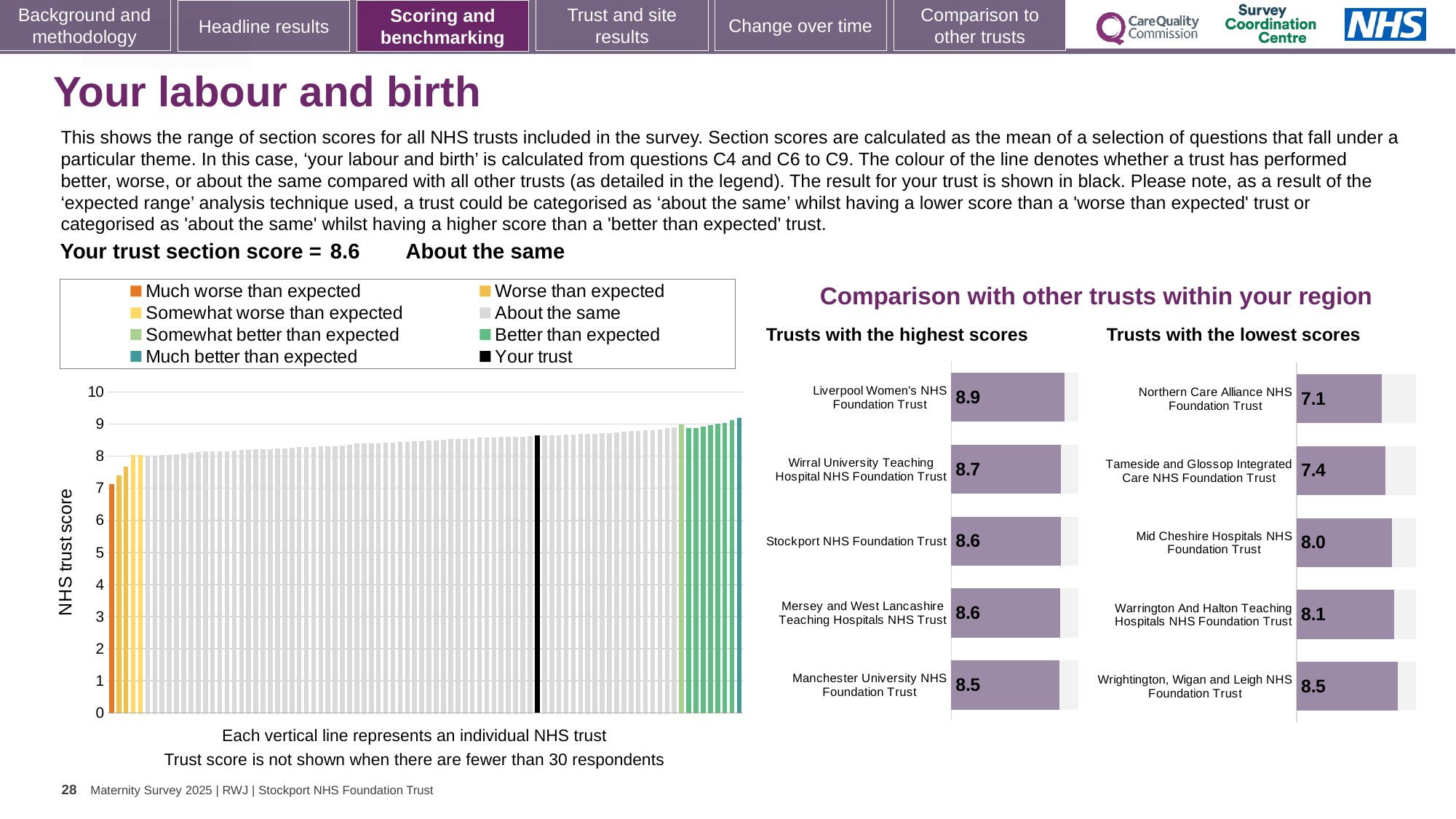
How many trusts are listed in the 'Trusts with the highest scores' chart? 5 How many entries does the legend of the large chart on the left list? 8 In the 'Trusts with the lowest scores' chart, what is the score for Northern Care Alliance NHS Foundation Trust? 7.1 In the 'Trusts with the highest scores' chart, what is the score for Wirral University Teaching Hospital NHS Foundation Trust? 8.7 In the 'Trusts with the highest scores' chart, what is the difference between the scores of Liverpool Women's NHS Foundation Trust and Manchester University NHS Foundation Trust? 0.4 In the 'Trusts with the highest scores' chart, what is the score for Liverpool Women's NHS Foundation Trust? 8.9 In the 'Trusts with the highest scores' chart, which trust has the highest score? Liverpool Women's NHS Foundation Trust In the 'Trusts with the lowest scores' chart, what is the score for Mid Cheshire Hospitals NHS Foundation Trust? 8.0 In the 'Trusts with the lowest scores' chart, which has the higher score: Tameside and Glossop Integrated Care NHS Foundation Trust or Warrington And Halton Teaching Hospitals NHS Foundation Trust? Warrington And Halton Teaching Hospitals NHS Foundation Trust In the 'Trusts with the lowest scores' chart, which trust has the lowest score? Northern Care Alliance NHS Foundation Trust In the large chart on the left showing all NHS trusts, do the scores rise or fall from left to right? rise In the 'Trusts with the lowest scores' chart, what is the difference between the scores of Wrightington, Wigan and Leigh NHS Foundation Trust and Northern Care Alliance NHS Foundation Trust? 1.4